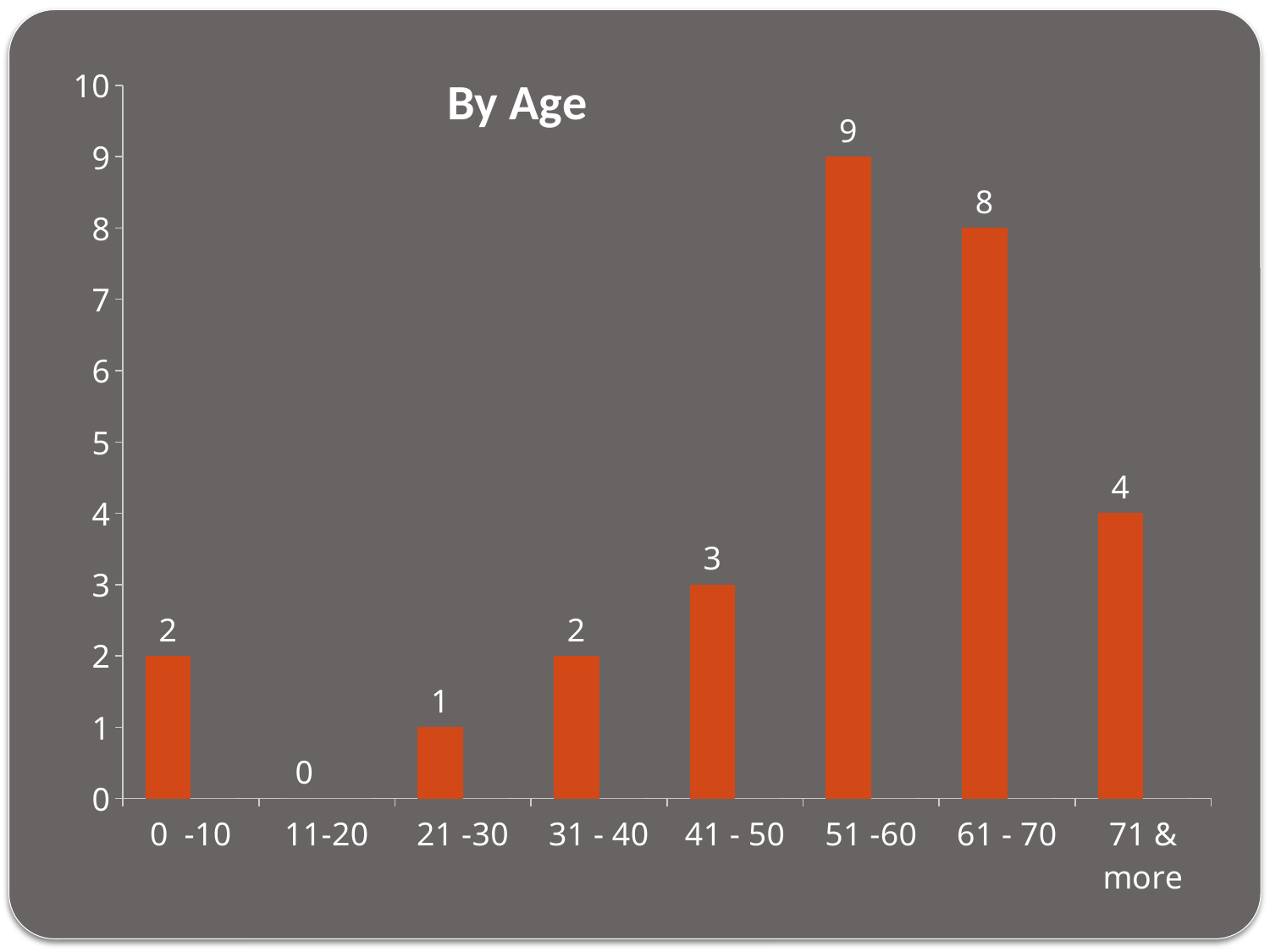
Which is larger, the value for 41-50 or the value for 31-40? 41-50 Which age group has the lowest value? 11-20 What is the value for the 51-60 age group? 9 What is the difference between the values for 51-60 and 61-70? 1 What is the value for the 11-20 age group? 0 Which age group has the highest value? 51-60 Do the values rise or fall from the 21-30 group to the 51-60 group? rise What is the value for the 71 & more age group? 4 How many age groups are shown on the chart? 8 What is the difference between the values for 71 & more and 41-50? 1 What kind of chart is this? bar chart What is the title of the chart? By Age